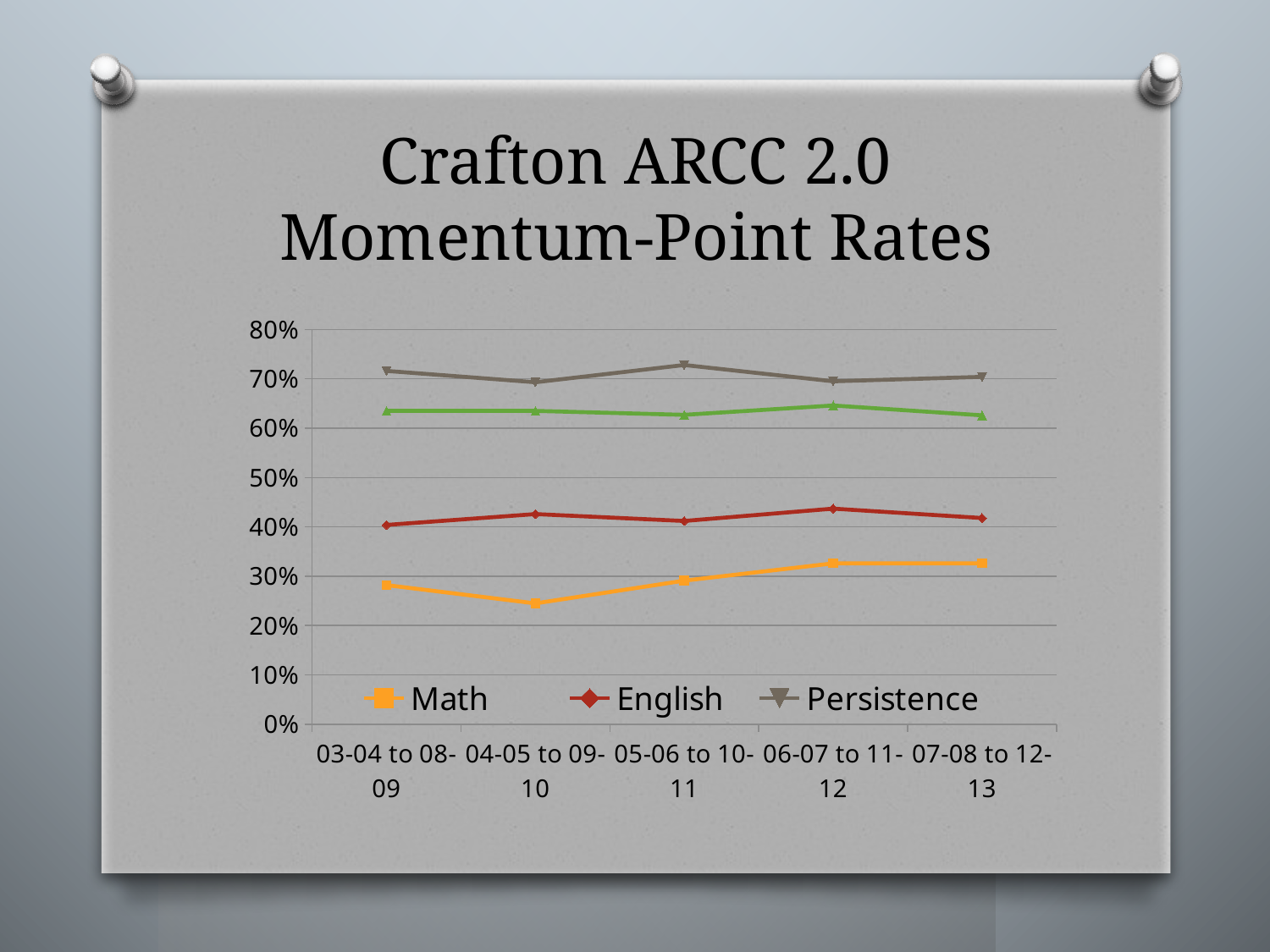
What is the title of the chart? Crafton ARCC 2.0 Momentum-Point Rates Does the Math rate rise or fall from 04-05 to 09-10 through 07-08 to 12-13? rise Is the Math value for 07-08 to 12-13 greater or less than 30%? greater Which series has the higher value for 03-04 to 08-09, Math or English? English Is the English value for 06-07 to 11-12 greater or less than 40%? greater Is the Math value for 04-05 to 09-10 greater or less than 30%? less What colour is the Math line in the legend? orange For which cohort is the Math rate lowest? 04-05 to 09-10 What kind of chart is shown on the slide? line chart How many cohort categories are shown on the x axis? 5 How many series does the legend list? 3